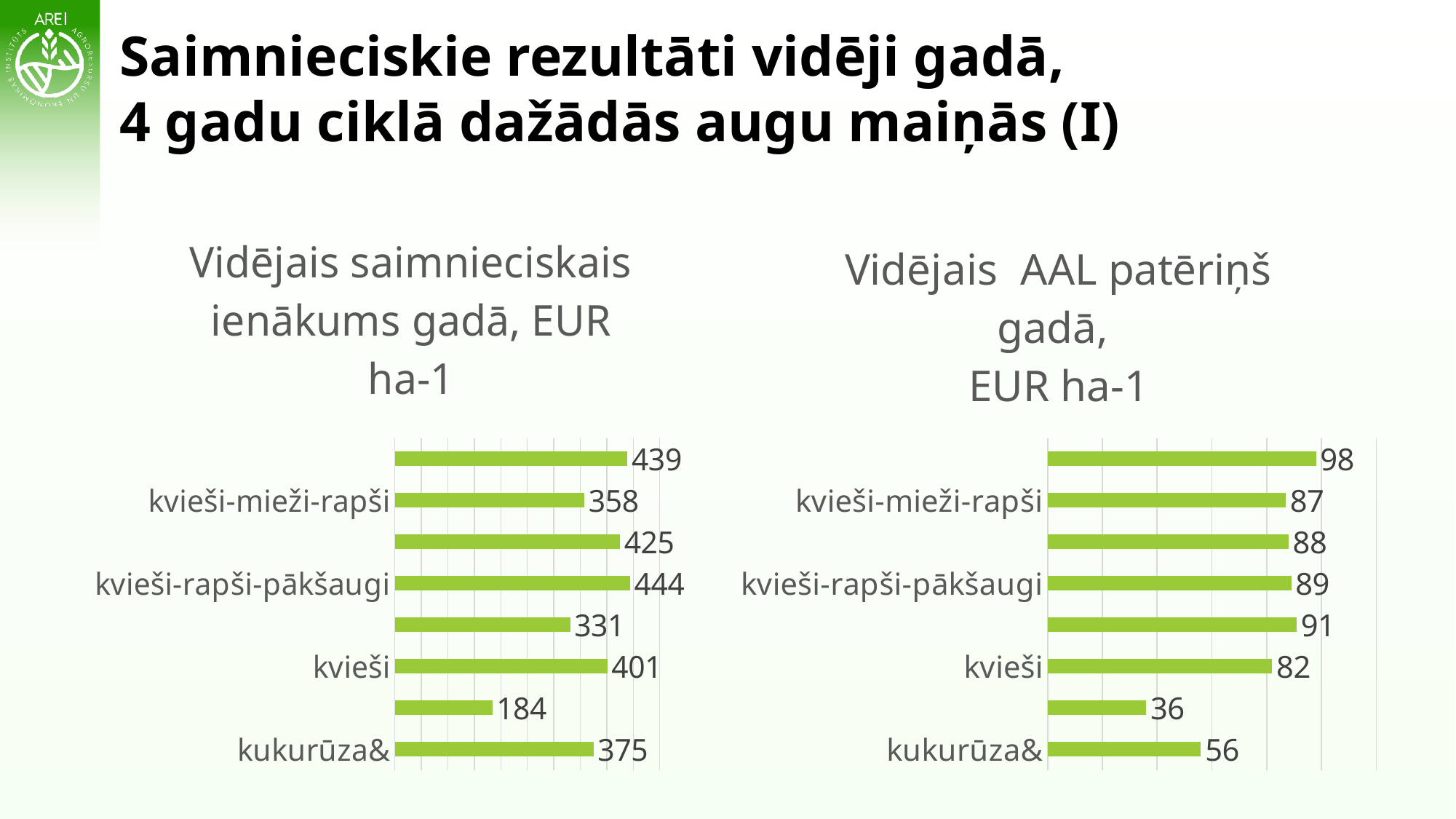
In the chart titled 'Vidējais AAL patēriņš gadā, EUR ha-1', what is the value for kvieši-mieži-rapši? 87 What kind of chart is the chart titled 'Vidējais AAL patēriņš gadā, EUR ha-1'? bar chart In the chart titled 'Vidējais AAL patēriņš gadā, EUR ha-1', which is larger, kvieši-rapši-pākšaugi or kvieši? kvieši-rapši-pākšaugi In the chart titled 'Vidējais saimnieciskais ienākums gadā, EUR ha-1', what is the difference between kvieši-rapši-pākšaugi and kvieši-mieži-rapši? 86 How many bars does the chart titled 'Vidējais saimnieciskais ienākums gadā, EUR ha-1' show? 8 In the chart titled 'Vidējais AAL patēriņš gadā, EUR ha-1', what is the value for kukurūza&? 56 In the chart titled 'Vidējais saimnieciskais ienākums gadā, EUR ha-1', what is the value for kvieši-rapši-pākšaugi? 444 In the chart titled 'Vidējais AAL patēriņš gadā, EUR ha-1', what is the lowest value shown? 36 In the chart titled 'Vidējais saimnieciskais ienākums gadā, EUR ha-1', which labelled category has the highest value? kvieši-rapši-pākšaugi In the chart titled 'Vidējais AAL patēriņš gadā, EUR ha-1', what is the difference between kvieši and kukurūza&? 26 In the chart titled 'Vidējais saimnieciskais ienākums gadā, EUR ha-1', what is the lowest value shown? 184 In the chart titled 'Vidējais saimnieciskais ienākums gadā, EUR ha-1', what is the value for kvieši? 401